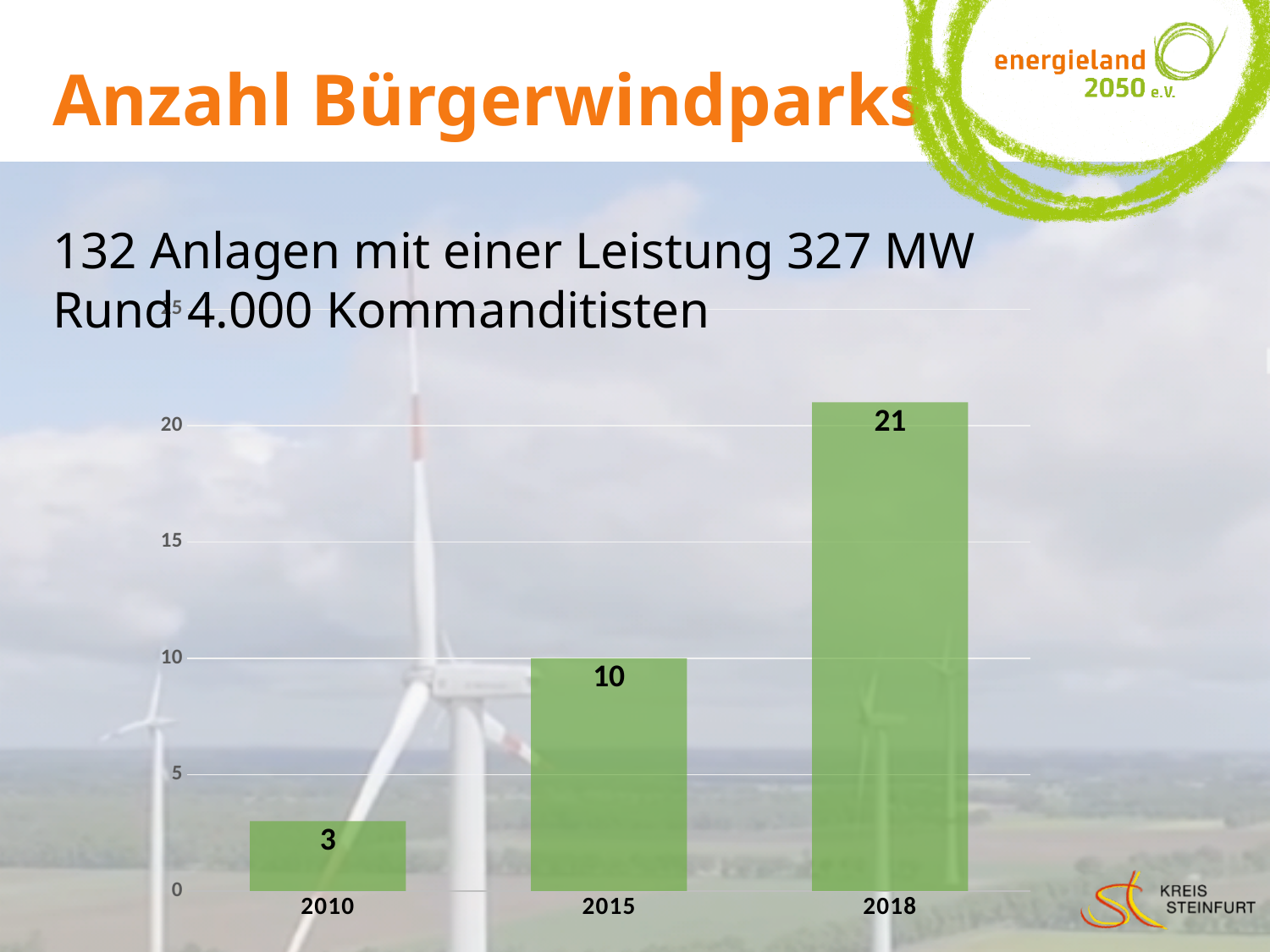
Which year has the lowest value? 2010 How many years are shown on the x axis? 3 What is the value for 2018? 21 What is the difference between the values for 2018 and 2015? 11 Is the value for 2018 greater or less than 20? greater What is the difference between the values for 2015 and 2010? 7 What is the value for 2010? 3 Which year has the highest value? 2018 What is the value for 2015? 10 Do the values rise or fall from 2010 to 2018? rise Which is larger, the value for 2015 or the value for 2010? 2015 What kind of chart is shown on the slide? bar chart